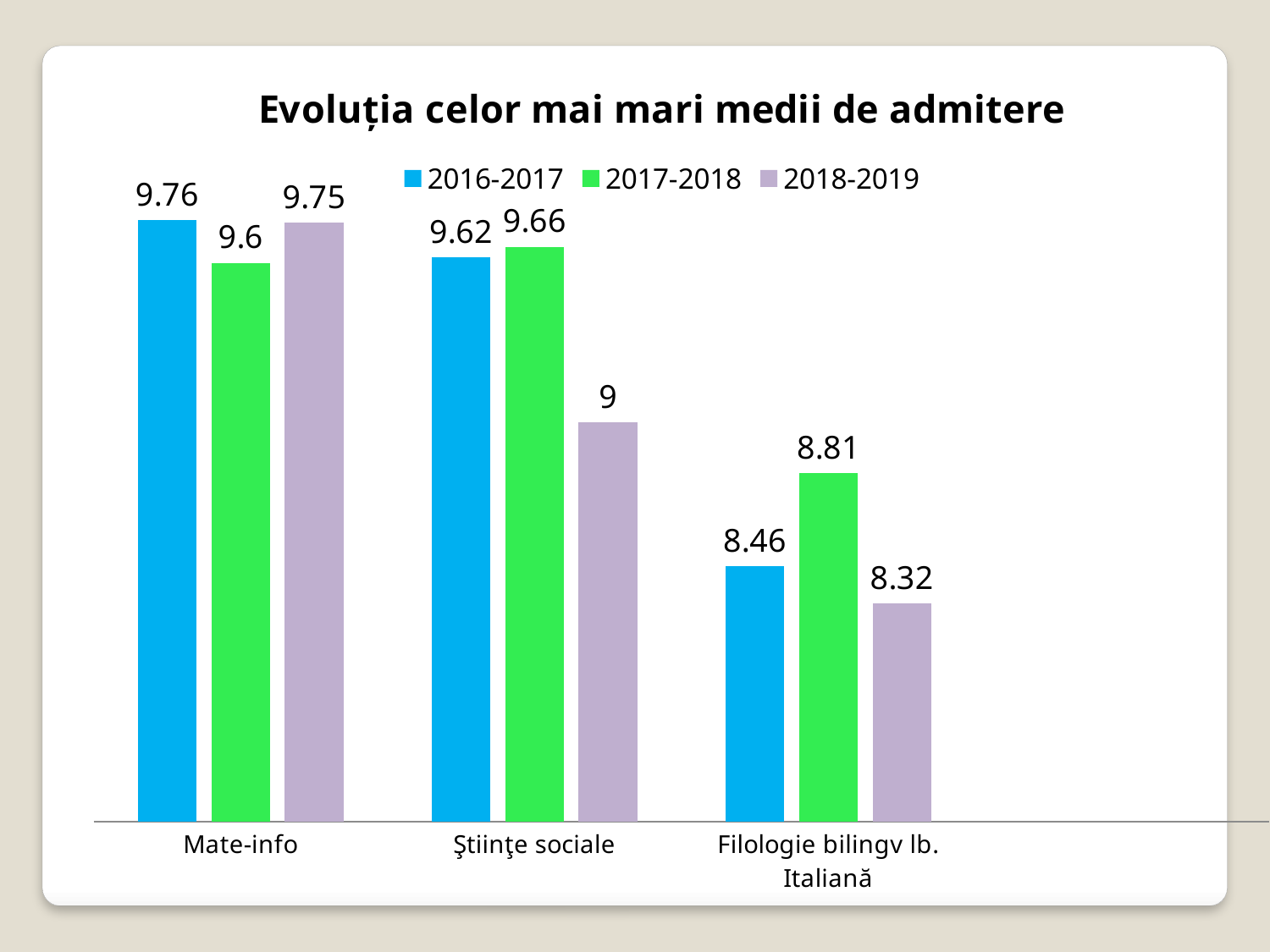
Which is larger for Mate-info: the 2016-2017 value or the 2017-2018 value? 2016-2017 How many categories are shown on the x axis? 3 What is the difference between the 2017-2018 and 2016-2017 values for Filologie bilingv lb. Italiană? 0.35 What is the difference between the 2016-2017 and 2018-2019 values for Ştiinţe sociale? 0.62 What is the value for Mate-info in 2016-2017? 9.76 How many series does the legend list? 3 What is the title of the chart? Evoluția celor mai mari medii de admitere Which category has the highest value in 2017-2018? Ştiinţe sociale What kind of chart is shown on the slide? Bar chart Which category has the lowest value in 2018-2019? Filologie bilingv lb. Italiană What is the value for Ştiinţe sociale in 2018-2019? 9 What is the value for Filologie bilingv lb. Italiană in 2017-2018? 8.81